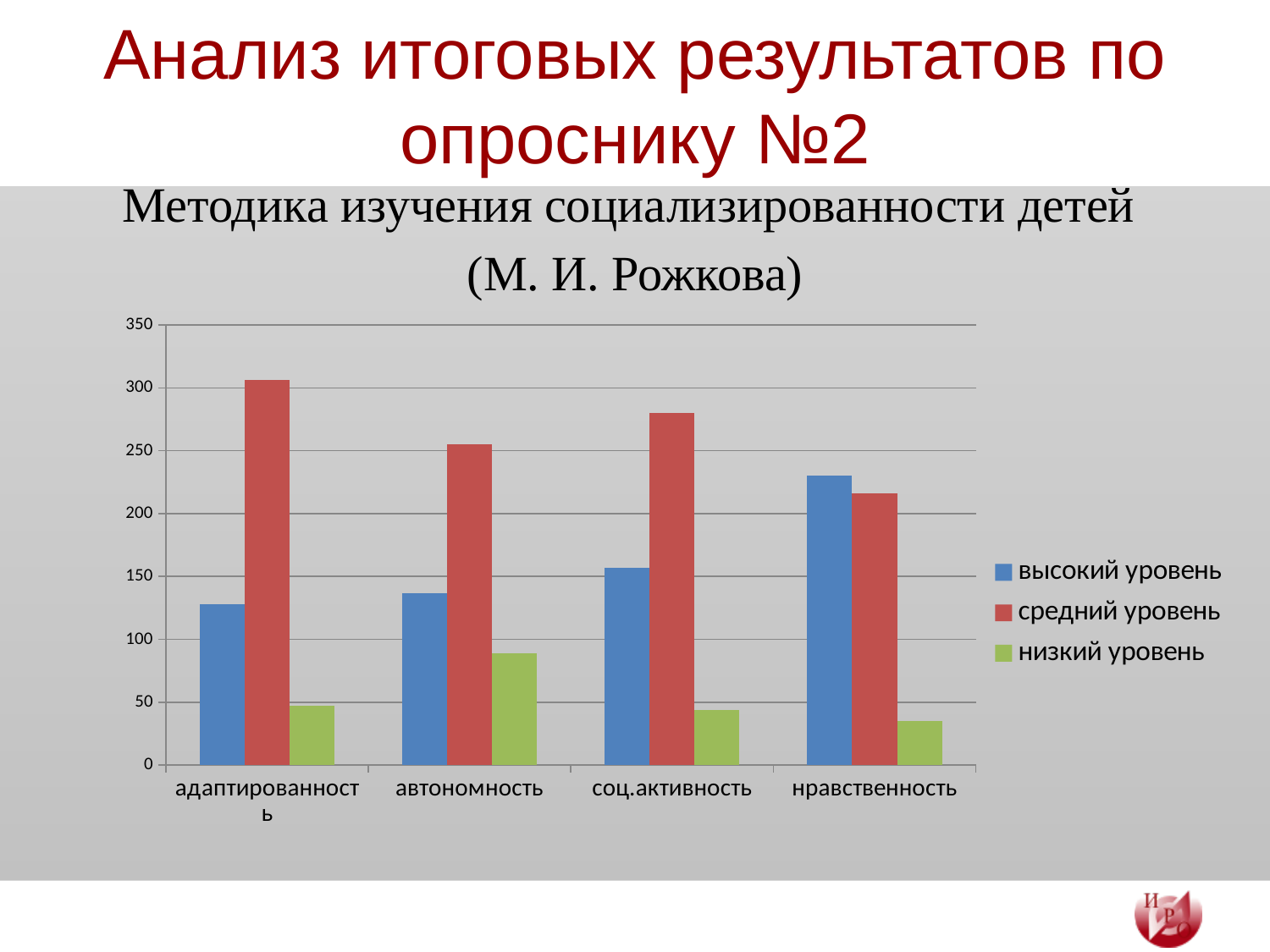
How many series does the legend list? 3 How many categories are shown on the x axis? 4 Which is larger: средний уровень for автономность or средний уровень for соц.активность? соц.активность Which category has the highest value for средний уровень? адаптированность What is the title of the chart? Методика изучения социализированности детей (М. И. Рожкова) Which category has the highest value for низкий уровень? автономность Is the value for низкий уровень in автономность greater or less than 50? greater Which category has the highest value for высокий уровень? нравственность Is the value for средний уровень in адаптированность greater or less than 250? greater What kind of chart is shown on the slide? bar chart Do the values for высокий уровень rise or fall from left to right across the categories? rise Is the value for высокий уровень in адаптированность greater or less than 150? less